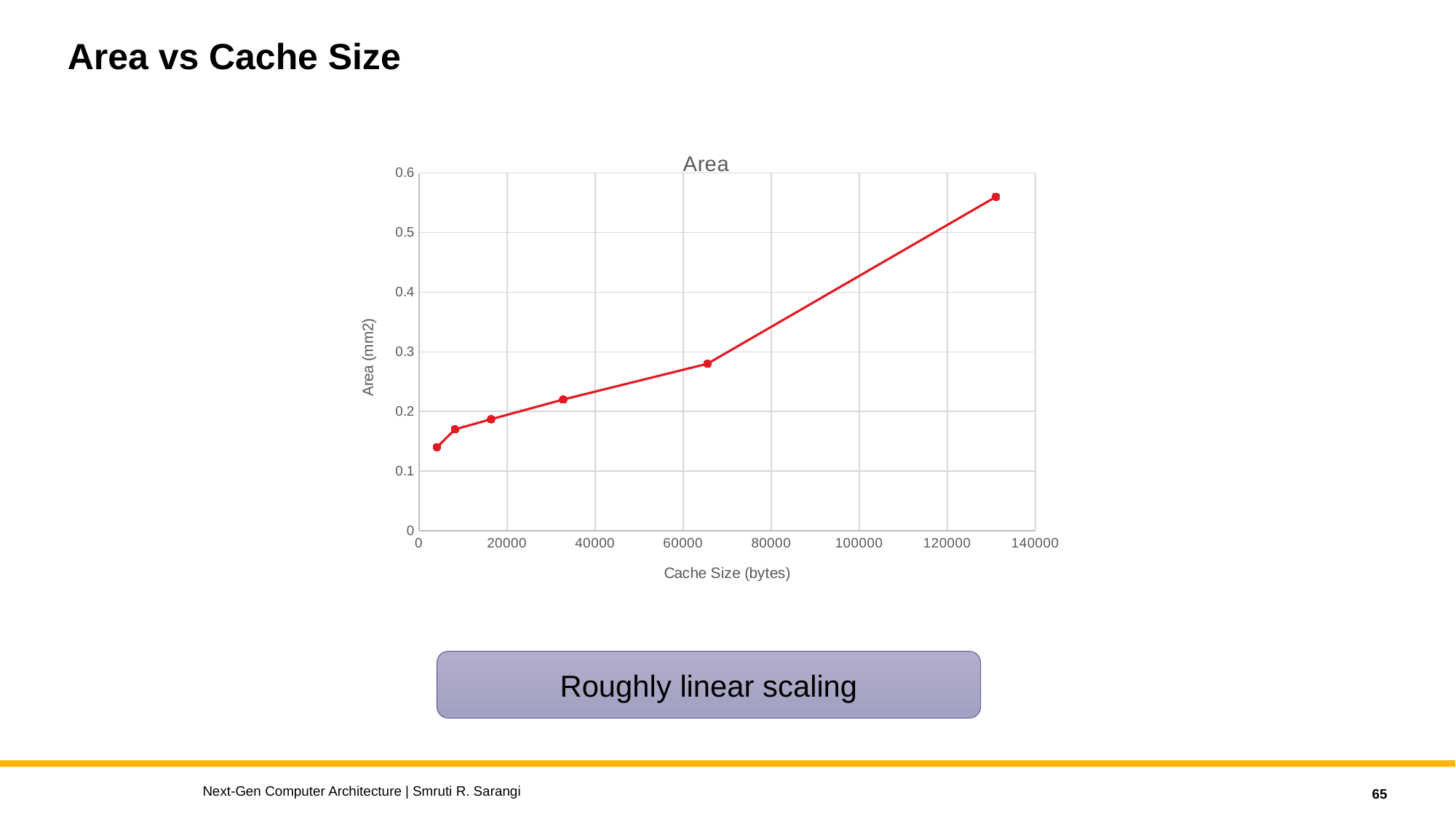
Which point has the highest area: the one at the largest cache size or the one at the smallest cache size? the one at the largest cache size How many data points are plotted on the line? 6 What is the highest value shown on the y axis? 0.6 Is the area value for the point at roughly 33000 bytes greater or less than 0.2? greater Is the area value for the rightmost point (largest cache size) greater or less than 0.5? greater Does the area rise or fall as cache size increases along the x axis? rise Is the area value for the leftmost point (smallest cache size) greater or less than 0.2? less What is the label of the x axis? Cache Size (bytes) What is the title of the chart? Area What kind of chart is shown on the slide? line chart